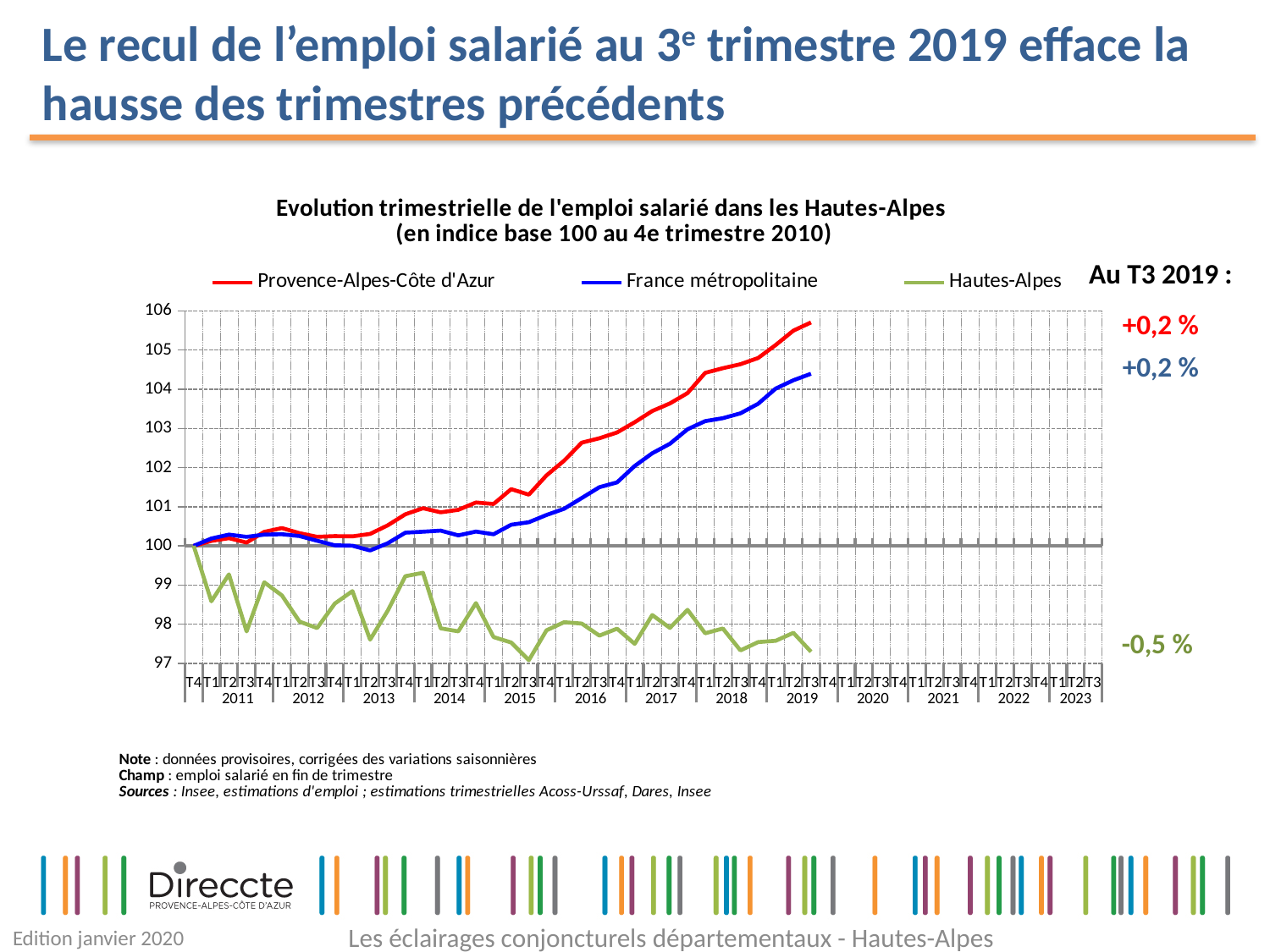
What is the index value of all three series at T4 2010? 100 What kind of chart is shown on the slide? line chart What is the title of the chart? Evolution trimestrielle de l'emploi salarié dans les Hautes-Alpes (en indice base 100 au 4e trimestre 2010) What quarterly change is annotated for Hautes-Alpes at T3 2019? -0,5 % Is the index value for Hautes-Alpes at T3 2019 greater or less than 98? less Which series is shown in green in the legend? Hautes-Alpes What quarterly change is annotated for Provence-Alpes-Côte d'Azur at T3 2019? +0,2 % Is the index value for Provence-Alpes-Côte d'Azur at T3 2019 greater or less than 105? greater How many series does the legend list? 3 Which series has the lowest index value at T3 2019? Hautes-Alpes Does the Provence-Alpes-Côte d'Azur series generally rise or fall from 2013 to 2019? rise Which series has the highest index value at T3 2019? Provence-Alpes-Côte d'Azur